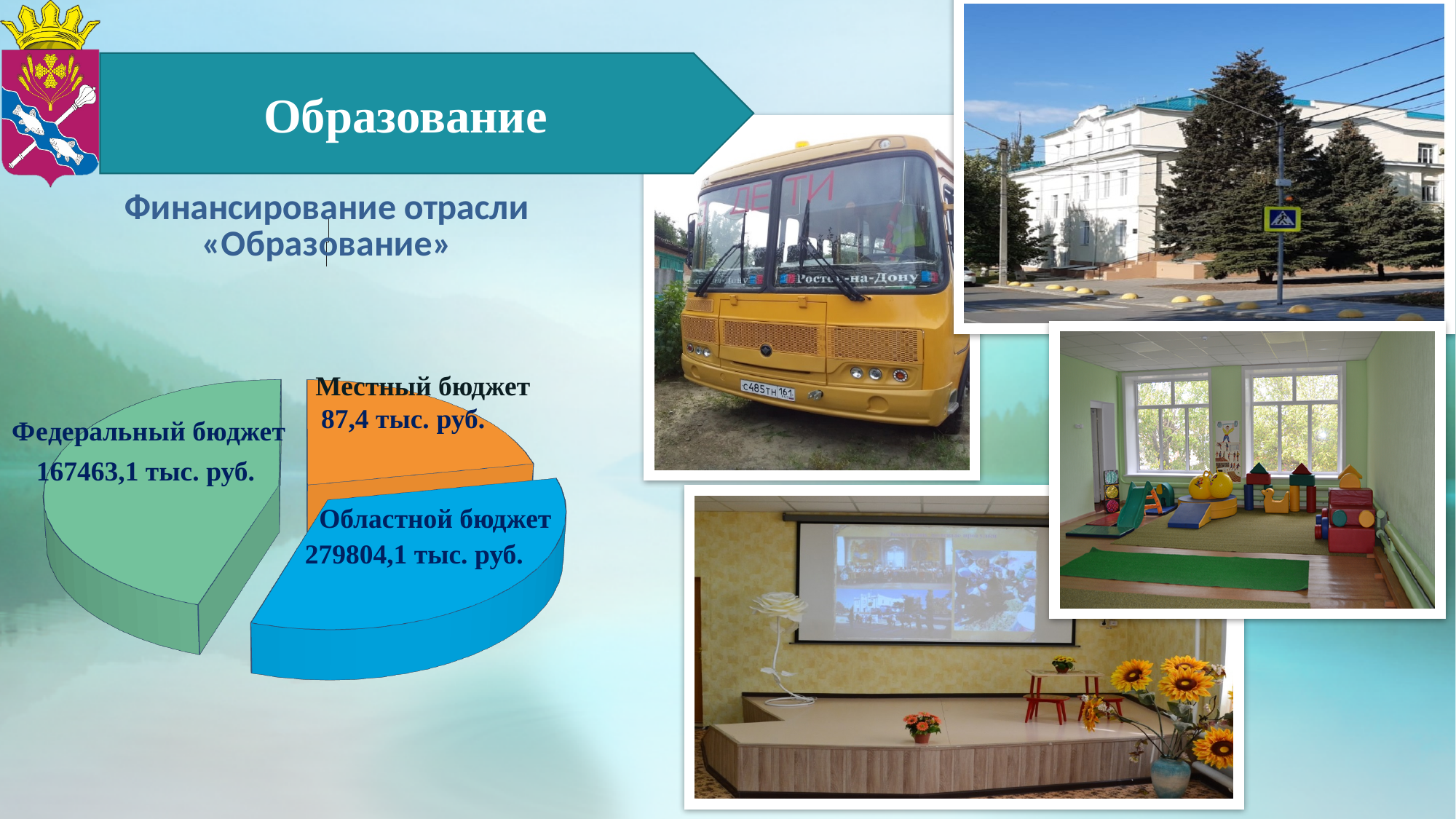
What is the total of the three budget values shown on the chart? 447354,6 тыс. руб. Which budget source has the lowest value according to the labels? Местный бюджет What kind of chart is shown on the slide? Pie chart What is the value for Федеральный бюджет? 167463,1 тыс. руб. What colour is the slice for Областной бюджет? Blue What is the value for Местный бюджет? 87,4 тыс. руб. How many slices does the pie chart have? 3 What is the difference between Областной бюджет and Федеральный бюджет? 112341,0 тыс. руб. What is the title of the chart on the slide? Финансирование отрасли «Образование» What is the value for Областной бюджет? 279804,1 тыс. руб. Which budget source has the highest value according to the labels? Областной бюджет Which is larger, Областной бюджет or Федеральный бюджет? Областной бюджет